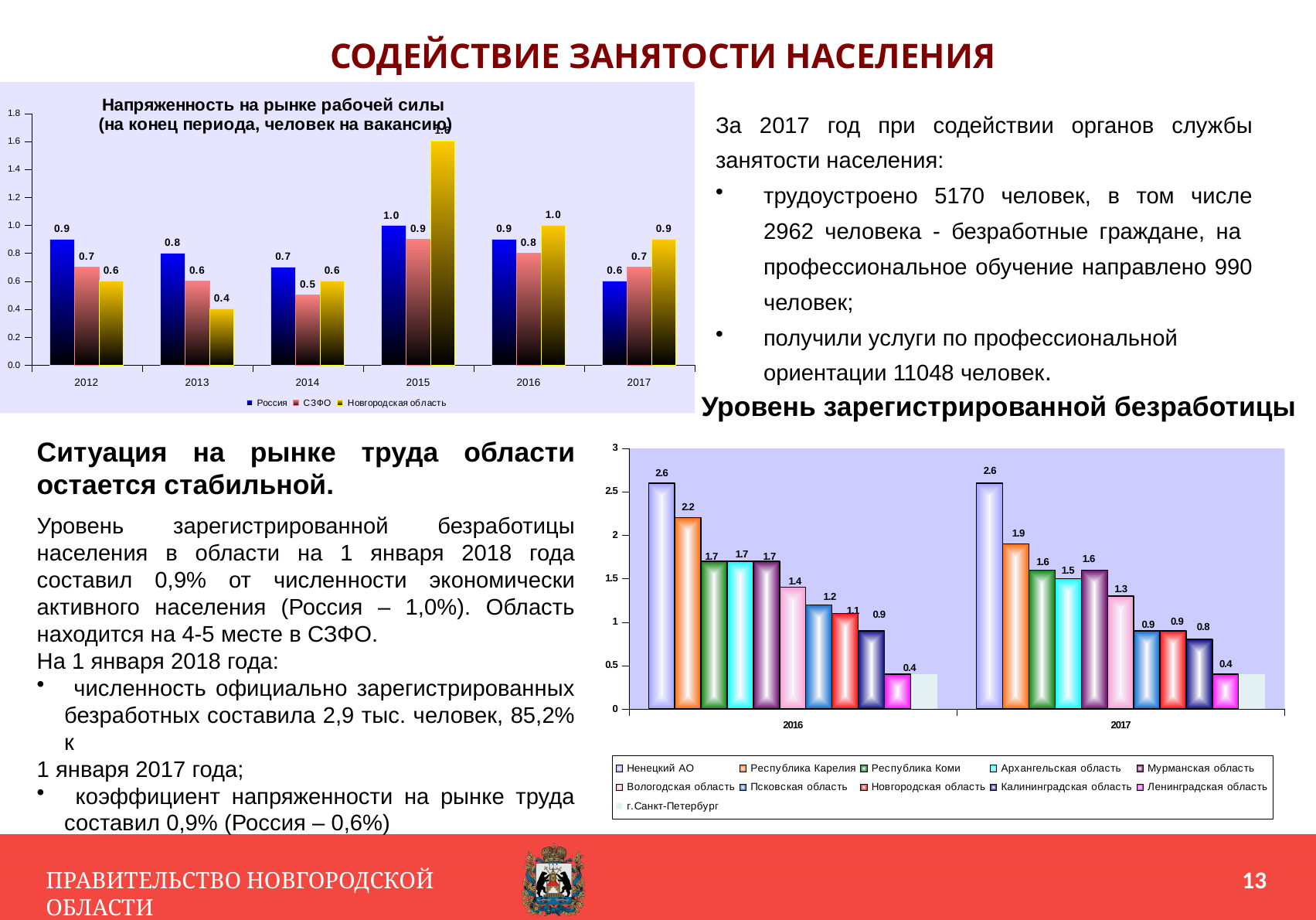
In the chart 'Уровень зарегистрированной безработицы', what is the value for Новгородская область in 2017? 0.9 In the chart 'Напряженность на рынке рабочей силы', in which year is the value for Новгородская область the lowest? 2013 In the chart 'Напряженность на рынке рабочей силы', what is the value for Новгородская область in 2015? 1.6 In the chart 'Напряженность на рынке рабочей силы', in which year is the value for Новгородская область the highest? 2015 In the chart 'Напряженность на рынке рабочей силы', how many years are shown on the x axis? 6 In the chart 'Уровень зарегистрированной безработицы', what is the difference between the Республика Карелия values in 2016 and 2017? 0.3 What kind of chart is 'Уровень зарегистрированной безработицы'? Bar chart In the chart 'Напряженность на рынке рабочей силы', what is the difference between the Новгородская область value and the Россия value in 2015? 0.6 In the chart 'Напряженность на рынке рабочей силы', how many series does the legend list? 3 In the chart 'Уровень зарегистрированной безработицы', which region has the highest value in 2016? Ненецкий АО In the chart 'Напряженность на рынке рабочей силы', what is the value for Россия in 2017? 0.6 In the chart 'Уровень зарегистрированной безработицы', which is larger in 2017: Республика Карелия or Республика Коми? Республика Карелия